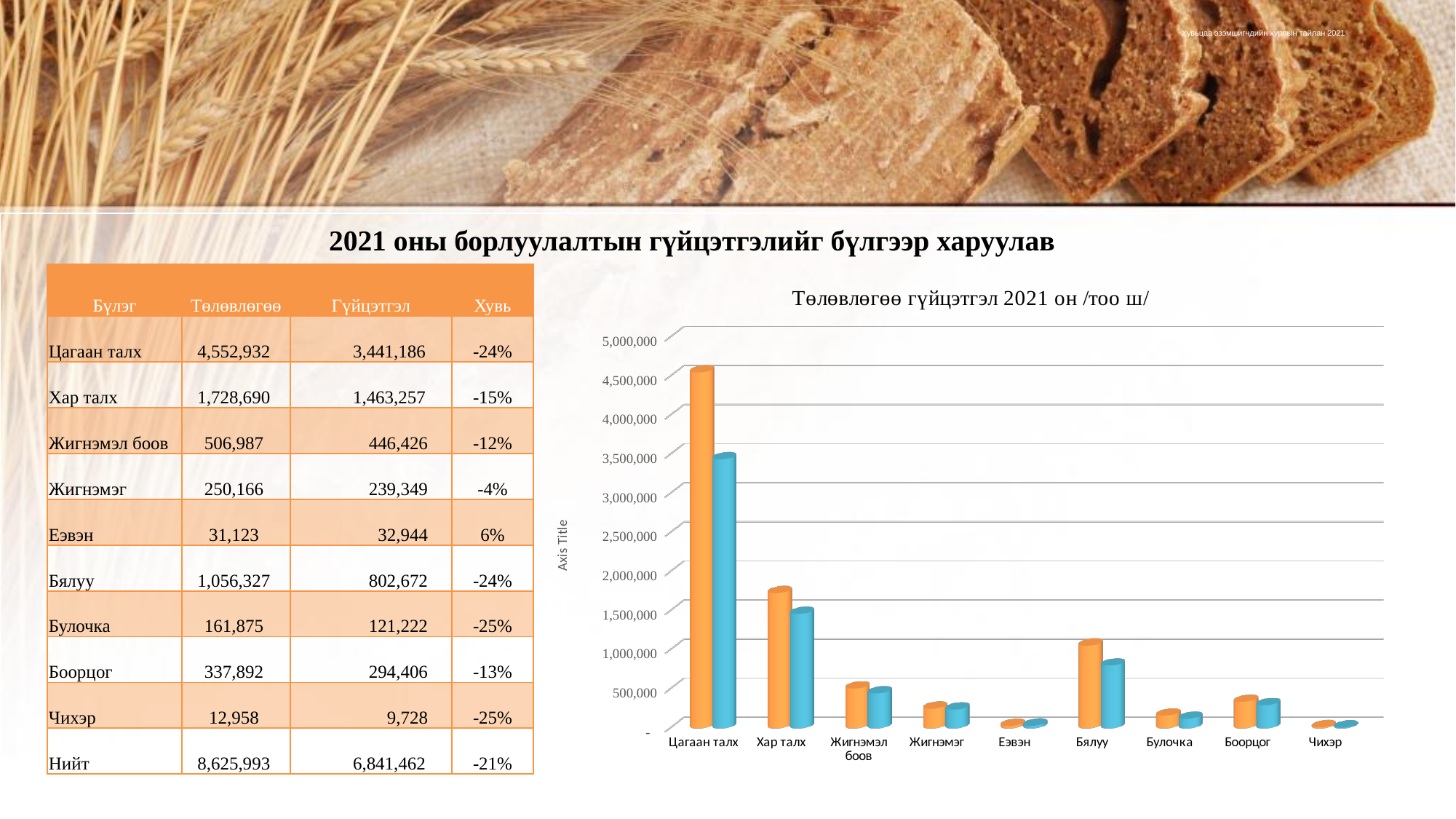
How many categories are shown on the x axis of the chart? 9 What kind of chart is shown on the slide? bar chart Which category has the shortest bars in the chart? Чихэр Is the orange bar for Цагаан талх greater or less than 4,000,000? greater Is the orange bar for Хар талх greater or less than 1,500,000? greater Which has the larger orange bar, Хар талх or Бялуу? Хар талх Is the blue bar for Цагаан талх greater or less than 3,000,000? greater What is the title of the chart? Төлөвлөгөө гүйцэтгэл 2021 он /тоо ш/ What is the label shown on the vertical axis of the chart? Axis Title Which category has the tallest bars in the chart? Цагаан талх